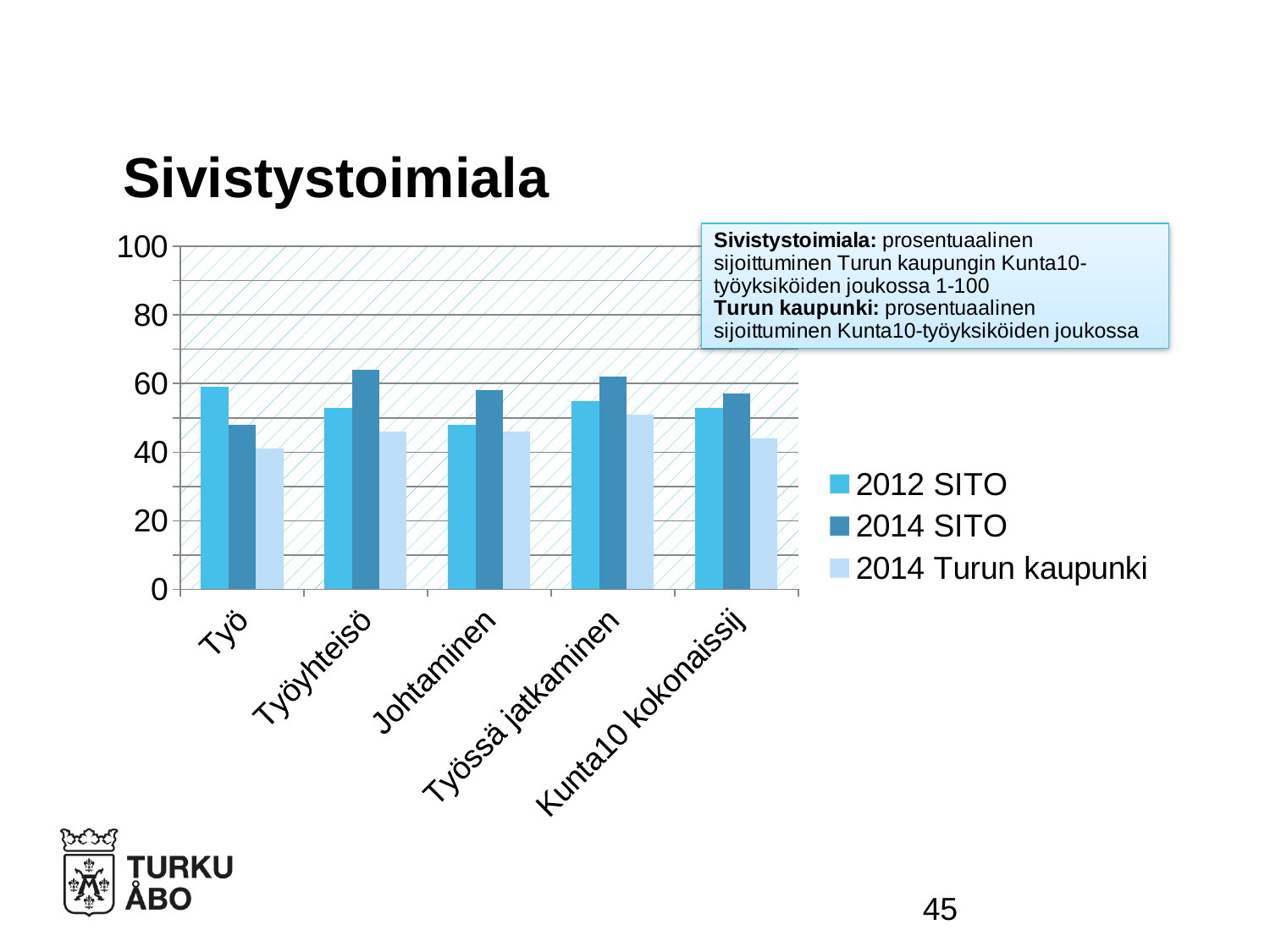
How many categories are shown on the x axis? 5 Which category has the highest 2014 Turun kaupunki value? Työssä jatkaminen Is the 2014 Turun kaupunki value for Työ greater or less than 60? less Which category has the lowest 2012 SITO value? Johtaminen How many series does the legend list? 3 Is the 2014 SITO value for Johtaminen greater or less than 40? greater For Työyhteisö, which is larger: the 2012 SITO value or the 2014 SITO value? 2014 SITO Is the 2012 SITO value for Työ greater or less than 80? less For Työ, which is larger: the 2012 SITO value or the 2014 SITO value? 2012 SITO What are the three series listed in the legend? 2012 SITO, 2014 SITO, 2014 Turun kaupunki What kind of chart is shown on the slide? bar chart